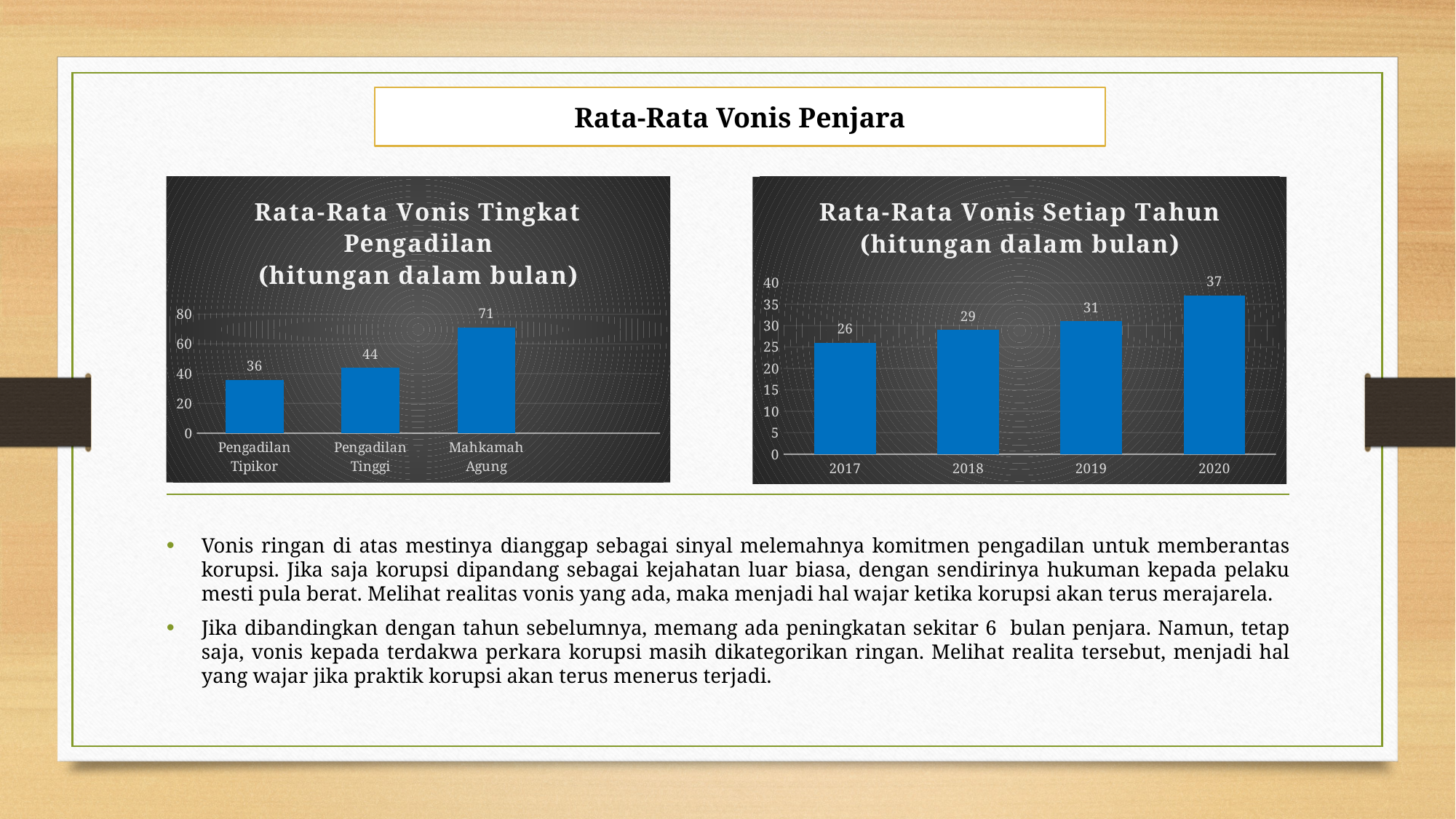
In the left chart (Rata-Rata Vonis Tingkat Pengadilan), what is the value for Mahkamah Agung? 71 What is the title of the left chart? Rata-Rata Vonis Tingkat Pengadilan (hitungan dalam bulan) In the left chart (Rata-Rata Vonis Tingkat Pengadilan), how many categories are shown? 3 In the right chart (Rata-Rata Vonis Setiap Tahun), what is the value for 2018? 29 In the left chart (Rata-Rata Vonis Tingkat Pengadilan), which category has the lowest value? Pengadilan Tipikor In the right chart (Rata-Rata Vonis Setiap Tahun), do the values rise or fall from 2017 to 2020? rise In the left chart (Rata-Rata Vonis Tingkat Pengadilan), what is the difference between Mahkamah Agung and Pengadilan Tinggi? 27 In the left chart (Rata-Rata Vonis Tingkat Pengadilan), what is the value for Pengadilan Tipikor? 36 What kind of chart is the right chart (Rata-Rata Vonis Setiap Tahun)? bar chart In the right chart (Rata-Rata Vonis Setiap Tahun), which year has the highest value? 2020 In the right chart (Rata-Rata Vonis Setiap Tahun), what is the difference between 2020 and 2017? 11 In the right chart (Rata-Rata Vonis Setiap Tahun), is the value for 2019 greater or less than 30? greater